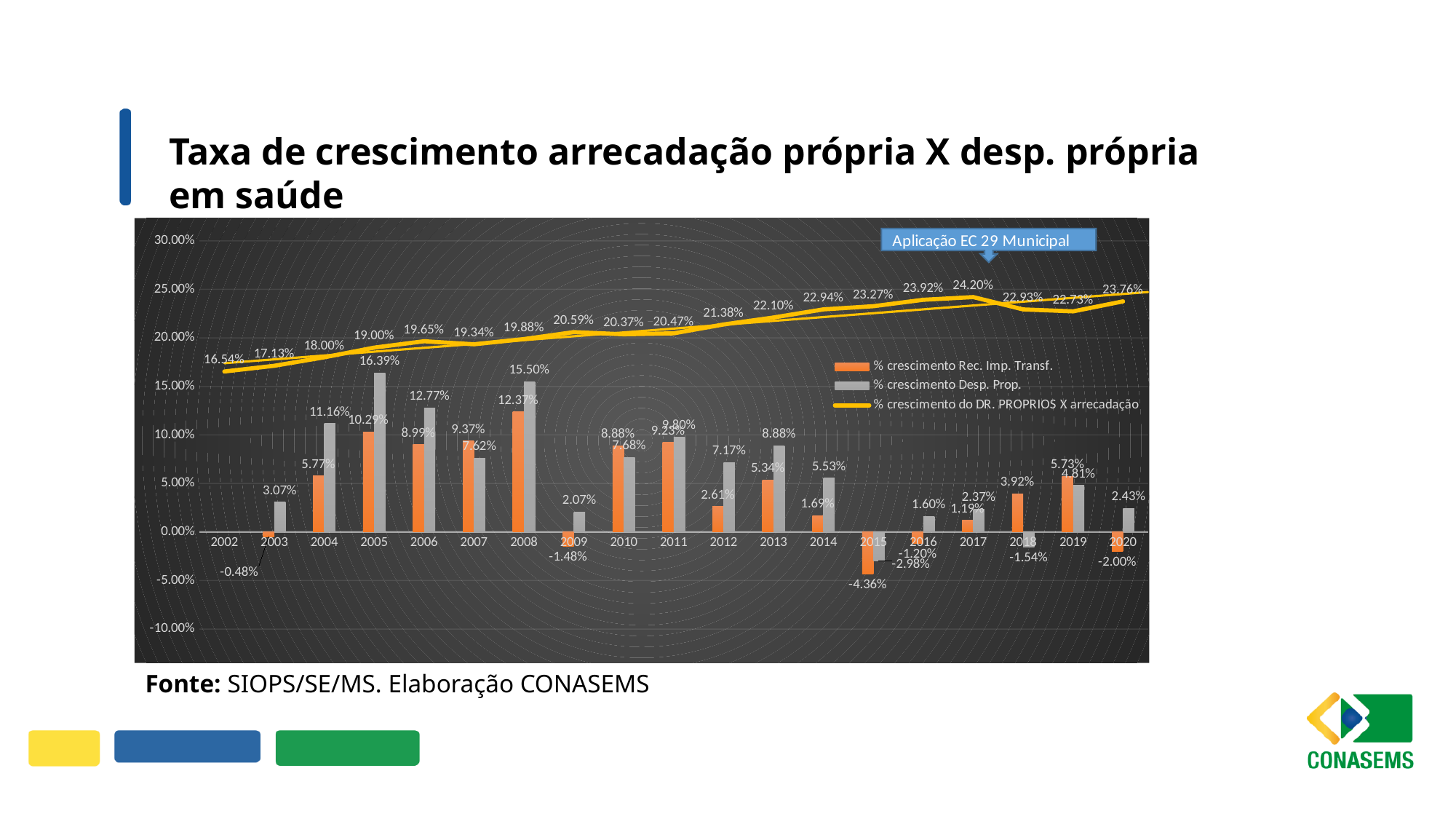
What does the blue annotation box at the top of the chart say? Aplicação EC 29 Municipal What is the value of '% crescimento Desp. Prop.' in 2005? 16.39% How many years are shown on the x axis? 19 What is the difference between '% crescimento Desp. Prop.' and '% crescimento Rec. Imp. Transf.' in 2004? 5.39% In which year is '% crescimento Desp. Prop.' highest? 2005 What is the value of the '% crescimento do DR. PROPRIOS X arrecadação' line in 2017? 24.20% In 2007, which is larger: '% crescimento Rec. Imp. Transf.' or '% crescimento Desp. Prop.'? % crescimento Rec. Imp. Transf. What kind of chart is shown on the slide? Bar chart with a line How many series does the legend list? 3 In which year is '% crescimento Rec. Imp. Transf.' lowest? 2015 Does the '% crescimento do DR. PROPRIOS X arrecadação' line generally rise or fall from 2002 to 2017? Rise What is the value of '% crescimento Rec. Imp. Transf.' in 2008? 12.37%